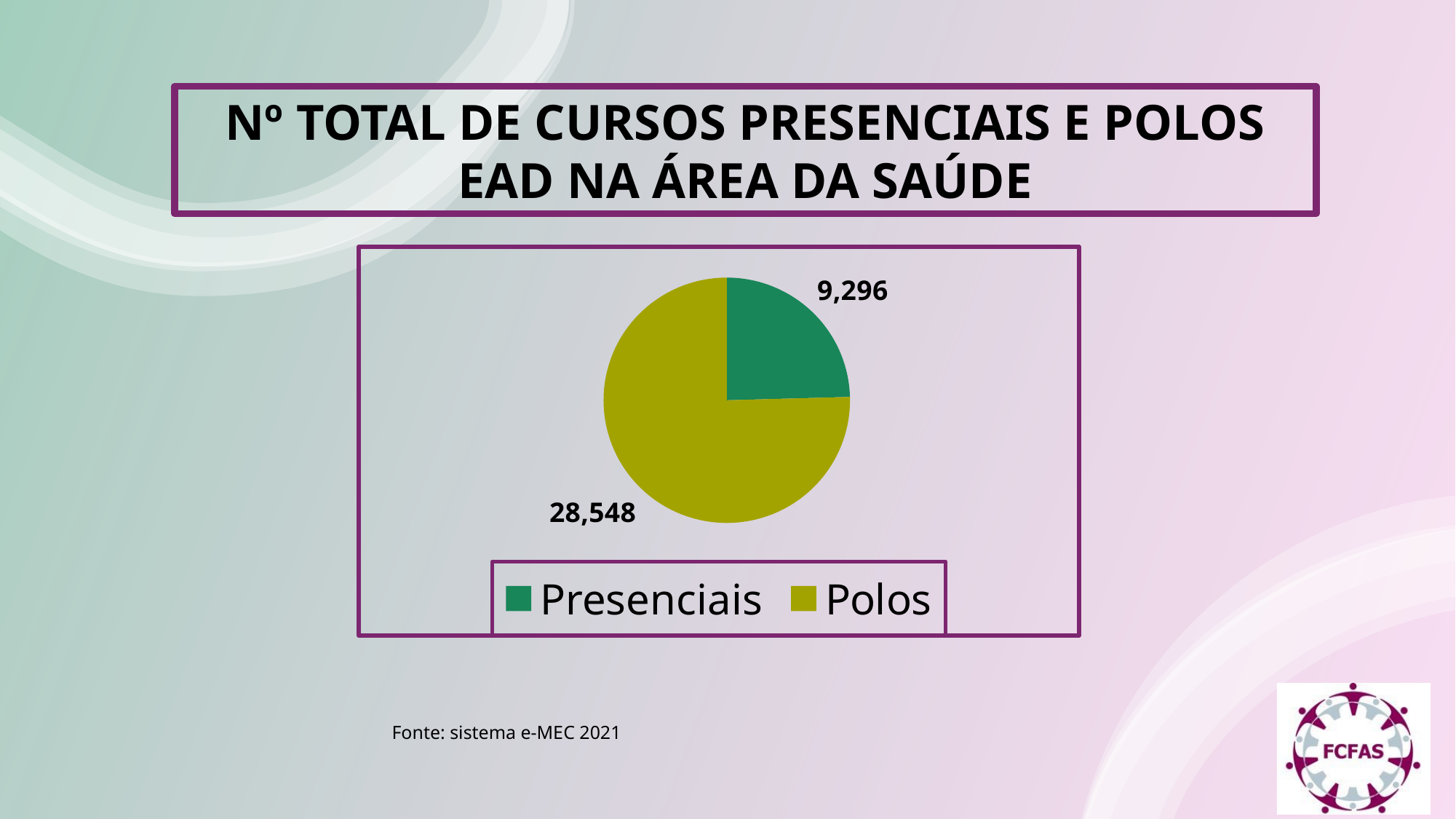
What is the value for Presenciais in the pie chart? 9,296 What is the value for Polos in the pie chart? 28,548 What colour is the Presenciais slice in the pie chart? Green What is the total of the two values shown in the pie chart? 37,844 Which category has the largest slice of the pie chart? Polos What source is cited below the chart? Fonte: sistema e-MEC 2021 How many categories does the pie chart show? 2 Which is larger, the value for Presenciais or the value for Polos? Polos Which category has the smallest slice of the pie chart? Presenciais What is the difference between the values for Polos and Presenciais? 19,252 What kind of chart is shown on the slide? Pie chart